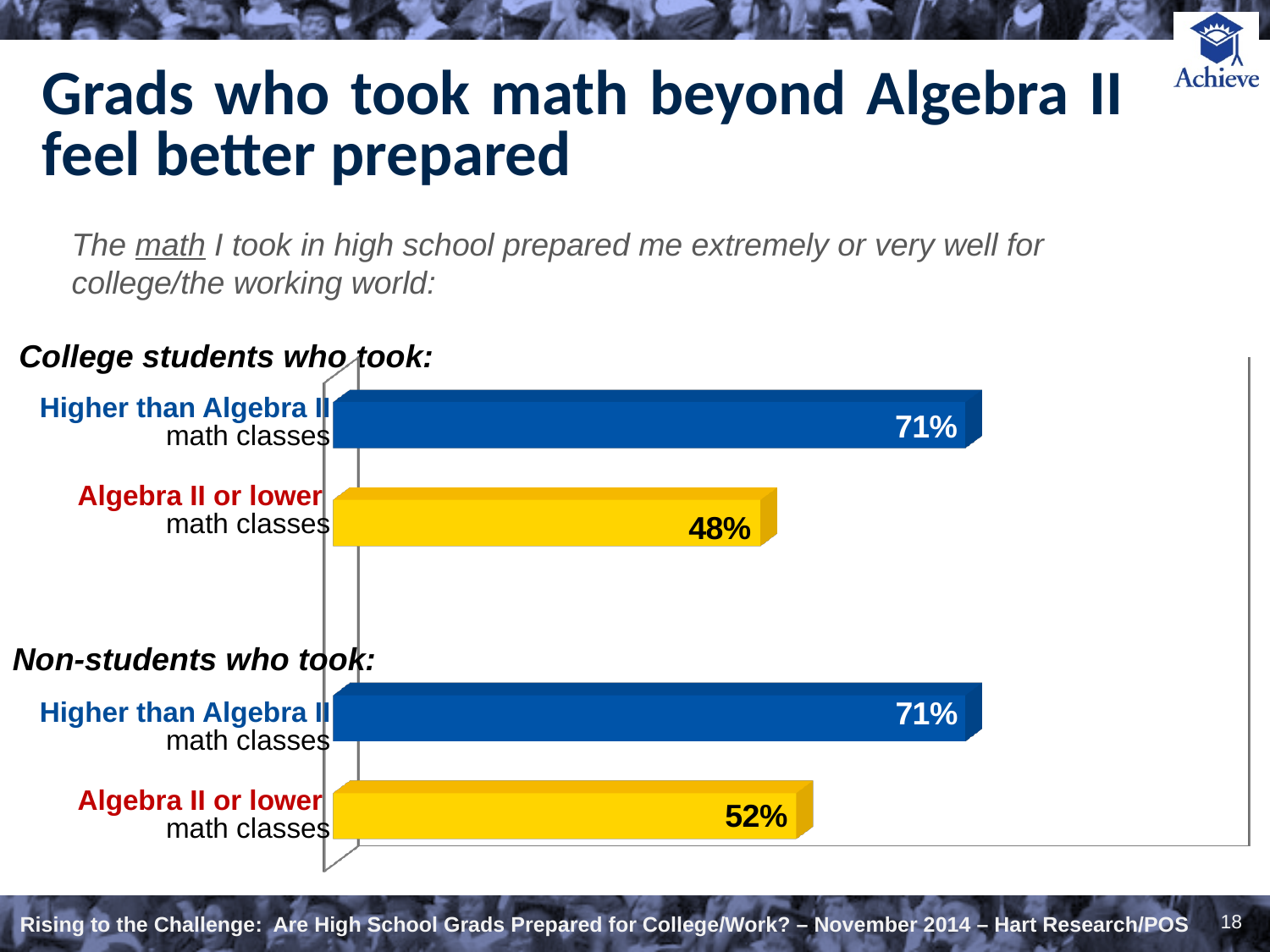
What percentage of college students who took Algebra II or lower math classes say their high school math prepared them extremely or very well? 48% Among those who took Algebra II or lower math classes, which group has the higher value: college students or non-students? Non-students What is the difference between college students who took higher than Algebra II and those who took Algebra II or lower? 23 percentage points How many bars are plotted on the chart? 4 What percentage of non-students who took higher than Algebra II math classes say their high school math prepared them extremely or very well? 71% What is the difference between non-students who took higher than Algebra II and those who took Algebra II or lower? 19 percentage points Which bar shows the lowest value on the chart? College students who took Algebra II or lower math classes What type of chart is shown on the slide? Bar chart What percentage of college students who took higher than Algebra II math classes say their high school math prepared them extremely or very well? 71% What percentage of non-students who took Algebra II or lower math classes say their high school math prepared them extremely or very well? 52% What colour are the bars for 'Algebra II or lower math classes'? Yellow What colour are the bars for 'Higher than Algebra II math classes'? Blue